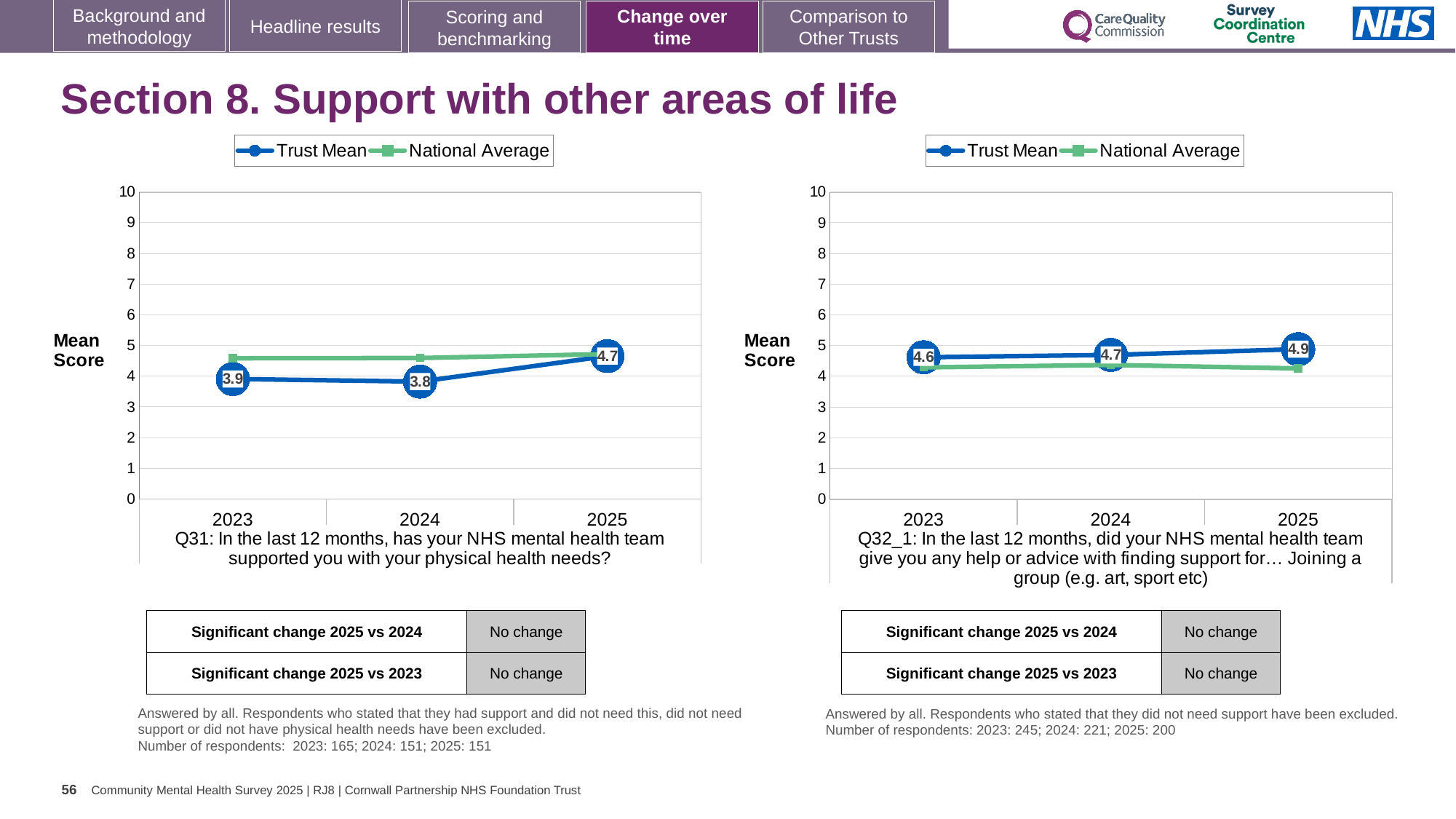
How many series does the legend of the left chart (Q31) list? 2 In the left chart (Q31), which year has the lowest Trust Mean? 2024 In the left chart (Q31), for 2024, which is larger: the Trust Mean or the National Average? National Average In the right chart (Q32_1), is the National Average for 2025 greater or less than 5? less In the right chart (Q32_1), which year has the highest Trust Mean? 2025 In the left chart (Q31), what is the difference between the Trust Mean for 2025 and the Trust Mean for 2024? 0.9 In the right chart (Q32_1), what is the difference between the Trust Mean for 2025 and the Trust Mean for 2023? 0.3 In the left chart (Q31), what is the Trust Mean for 2023? 3.9 In the right chart (Q32_1), what is the Trust Mean for 2024? 4.7 In the left chart (Q31), what is the Trust Mean for 2025? 4.7 What kind of chart is the right chart (Q32_1)? Line chart In the right chart (Q32_1), does the Trust Mean rise or fall from 2023 to 2025? Rise